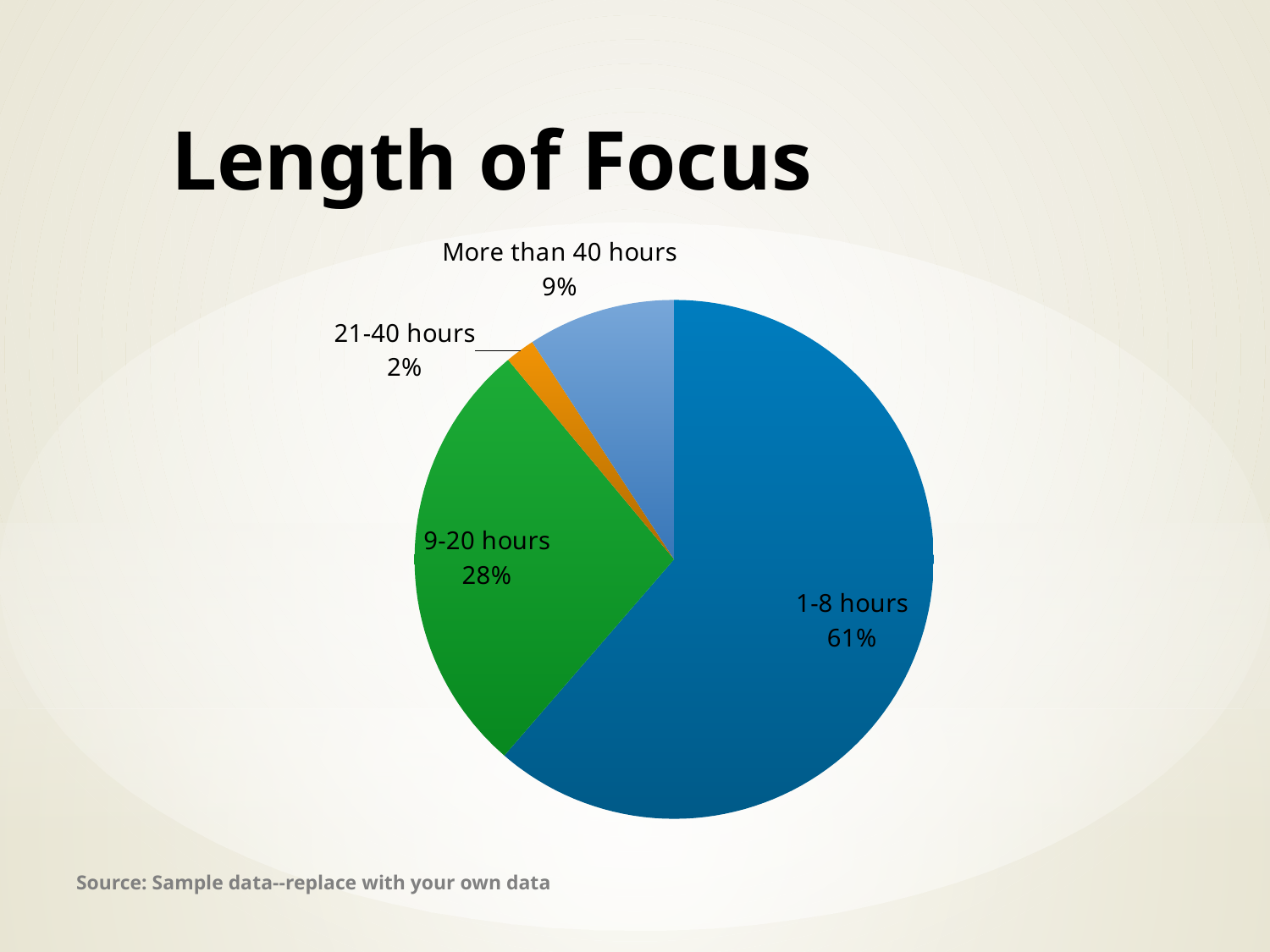
What share of the pie does the More than 40 hours slice represent? 9% Which category has the largest slice of the pie? 1-8 hours What kind of chart is shown on the slide? pie chart What colour is the 9-20 hours slice? green What share of the pie does the 9-20 hours slice represent? 28% What is the difference in percentage points between the 1-8 hours slice and the 9-20 hours slice? 33 How many slices does the pie chart have? 4 Which category has the smallest slice of the pie? 21-40 hours Which slice is larger, More than 40 hours or 21-40 hours? More than 40 hours What is the title of the slide containing the pie chart? Length of Focus What share of the pie does the 21-40 hours slice represent? 2%